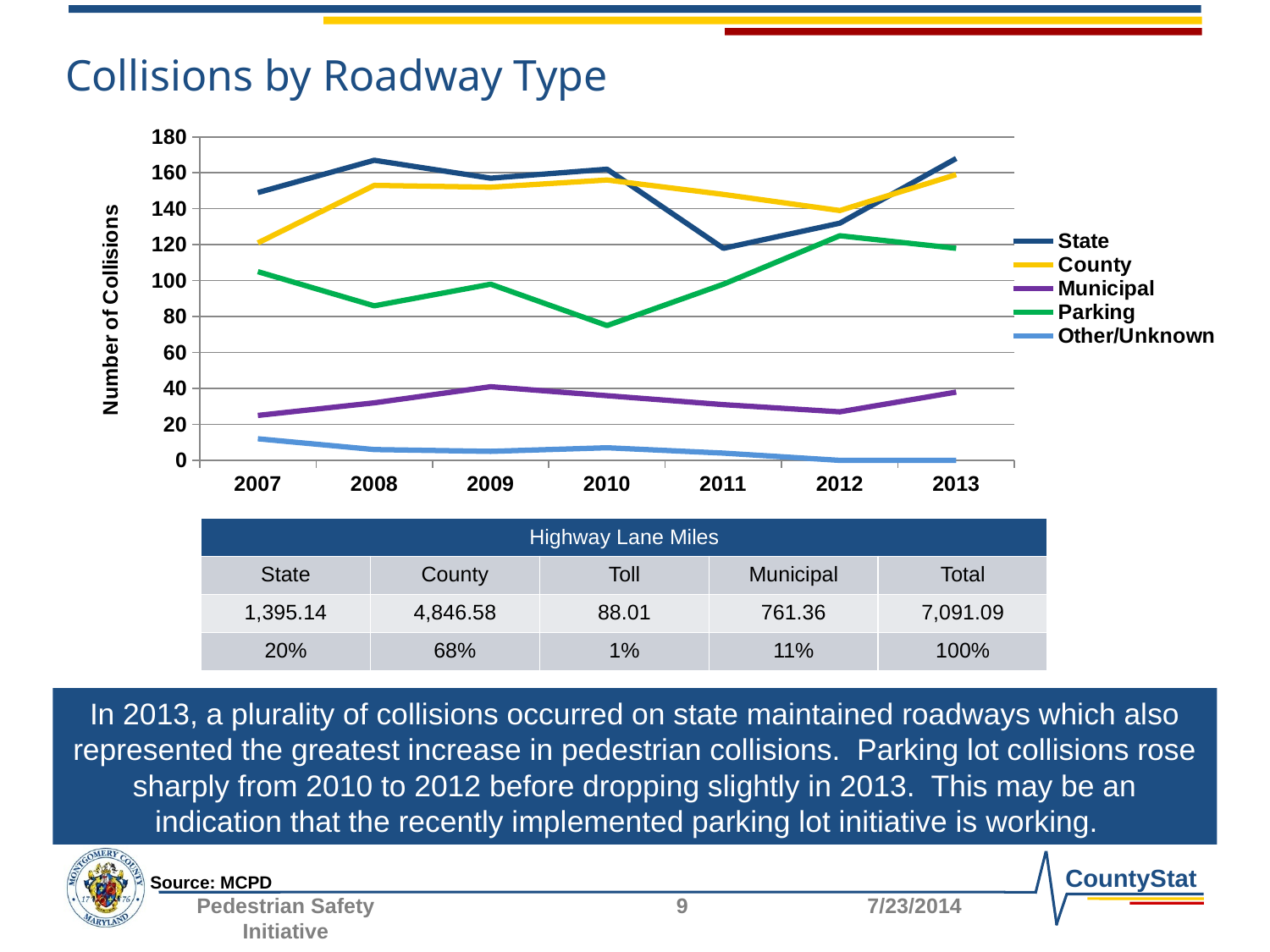
What kind of chart is shown on the slide? line chart Which series has the highest value in 2011? County In which year is the Parking series at its lowest? 2010 Which series is plotted with the green line? Parking What is the title of the chart's vertical axis? Number of Collisions Does the Parking series rise or fall from 2010 to 2012? rise Is the value for Parking in 2010 greater or less than 80? less Is the value for County in 2007 greater or less than 100? greater In which year is the State series at its lowest? 2011 Is the value for State in 2011 greater or less than 140? less How many years are shown along the x axis of the chart? 7 How many series does the chart's legend list? 5